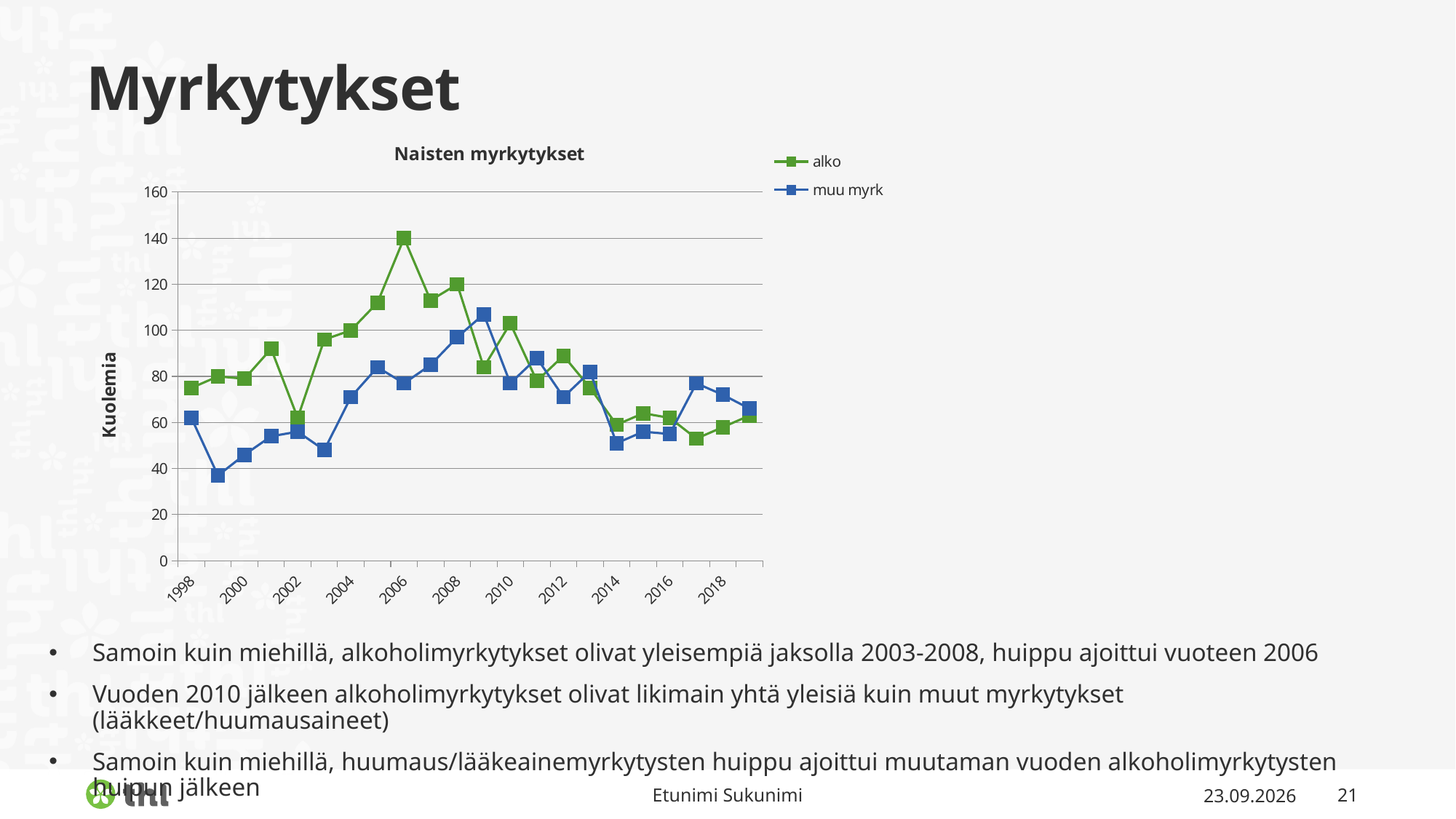
What is the title of the chart? Naisten myrkytykset In which year does the alko series reach its highest value? 2006 Is the value for alko in 2006 greater or less than 120? greater What are the two series named in the legend? alko and muu myrk In 2009, which series has the higher value, alko or muu myrk? muu myrk Is the value for muu myrk in 1999 greater or less than 40? less Is the value for muu myrk in 2009 greater or less than 100? greater In 2006, which series has the higher value, alko or muu myrk? alko What kind of chart is shown on the slide? line chart In which year does the muu myrk series reach its lowest value? 1999 Does the alko series generally rise or fall between 2008 and 2014? fall How many series does the legend list? 2